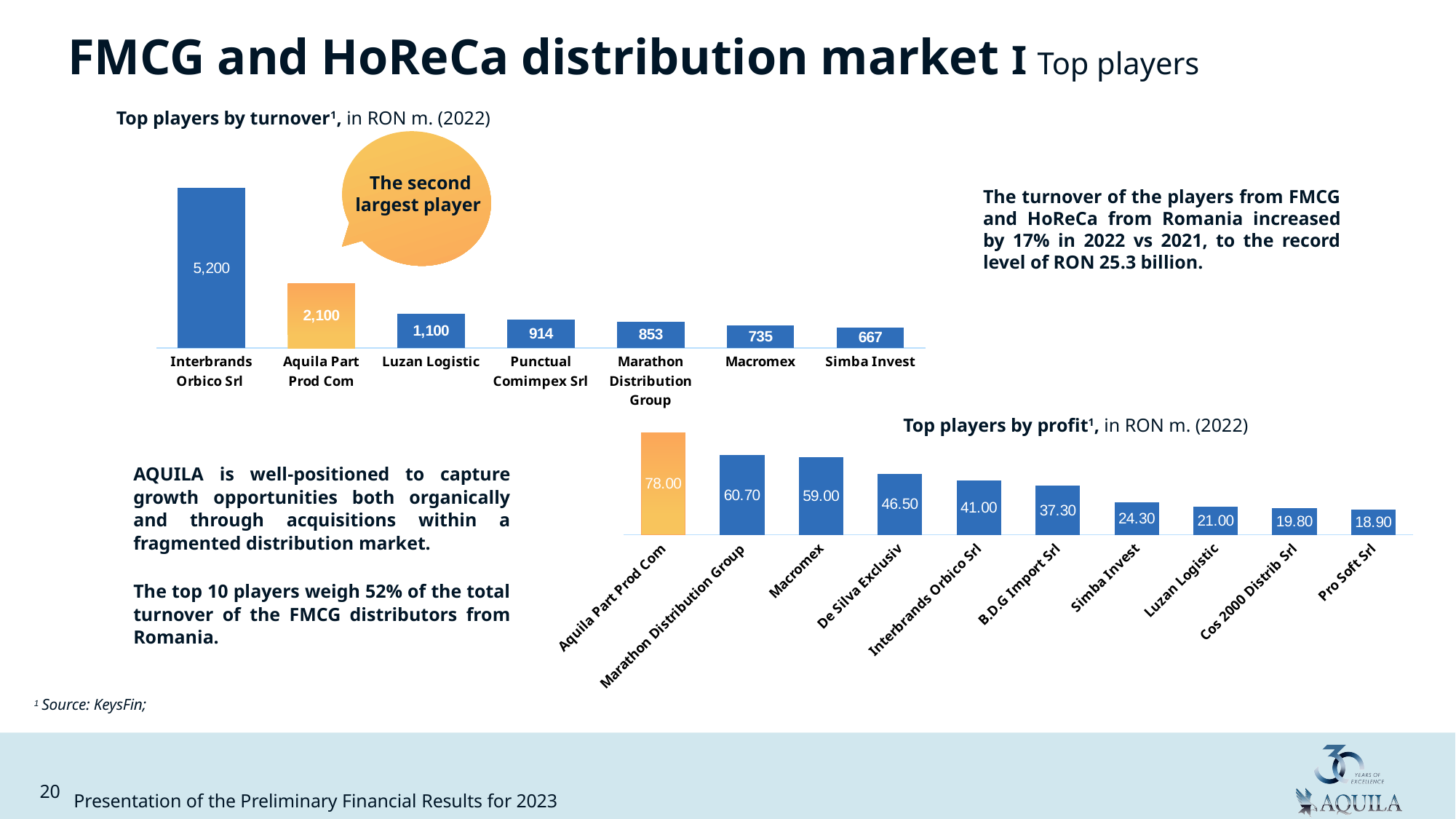
What type of chart is the 'Top players by profit' chart? Bar chart In the 'Top players by turnover' chart, what is the difference between the turnover of Luzan Logistic and Punctual Comimpex Srl? 186 In the 'Top players by turnover' chart, which has the higher turnover, Marathon Distribution Group or Macromex? Marathon Distribution Group In the 'Top players by profit' chart, what is the difference between the profit of Marathon Distribution Group and Macromex? 1.70 In the 'Top players by profit' chart, which player has the lowest profit? Pro Soft Srl In the 'Top players by profit' chart, how many players are shown? 10 In the 'Top players by turnover' chart, what is the turnover of Interbrands Orbico Srl? 5,200 In the 'Top players by profit' chart, what is the profit of Aquila Part Prod Com? 78.00 In the 'Top players by profit' chart, what is the profit of De Silva Exclusiv? 46.50 In the 'Top players by turnover' chart, which player has the lowest turnover? Simba Invest In the 'Top players by turnover' chart, what is the turnover of Aquila Part Prod Com? 2,100 In the 'Top players by turnover' chart, how many players are shown? 7